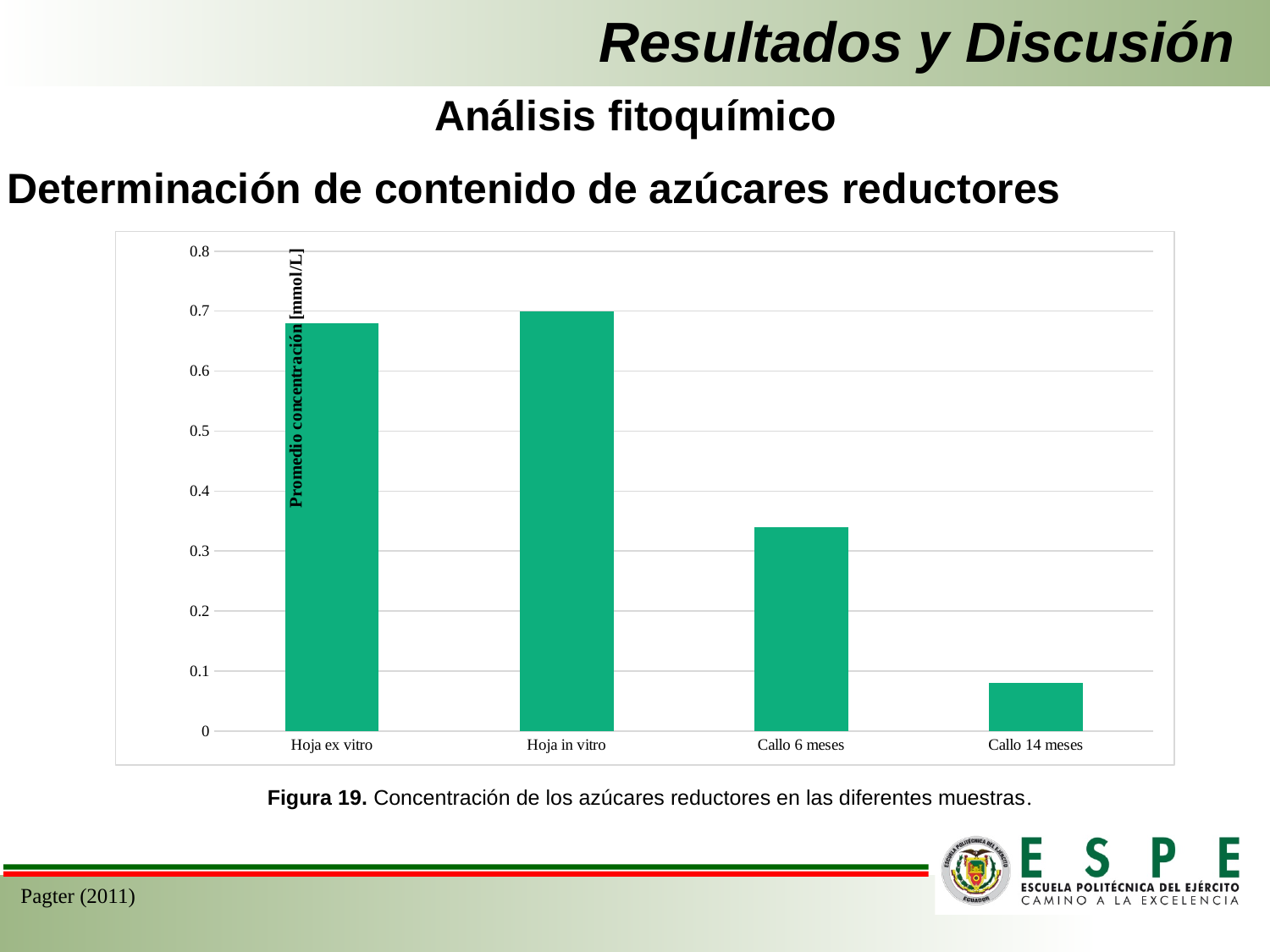
Is the value for Callo 14 meses greater or less than 0.1? less What is the label of the vertical axis of the chart? Promedio concentración [mmol/L] What kind of chart is shown on the slide? bar chart Which is larger, the value for Callo 6 meses or the value for Callo 14 meses? Callo 6 meses How many categories are shown on the x axis of the chart? 4 Is the value for Callo 6 meses greater or less than 0.3? greater What is the highest value shown on the vertical axis of the chart? 0.8 Is the value for Hoja ex vitro greater or less than 0.6? greater Which category has the lowest value in the chart? Callo 14 meses Which is larger, the value for Hoja ex vitro or the value for Callo 6 meses? Hoja ex vitro Do the values rise or fall from Hoja in vitro to Callo 14 meses along the x axis? fall